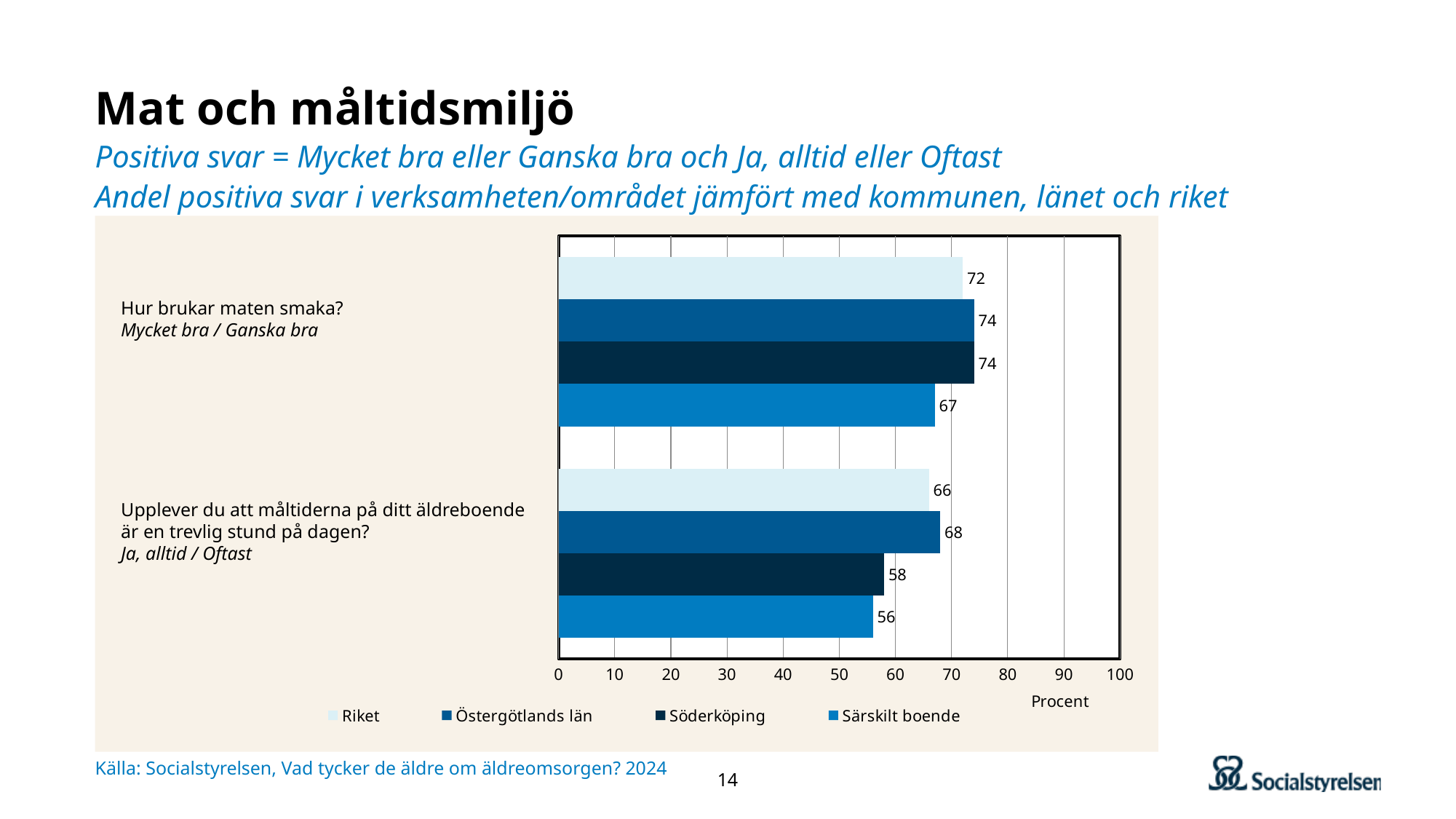
What is the value for Särskilt boende on the question "Hur brukar maten smaka?"? 67 What is the value for Söderköping on the question "Hur brukar maten smaka?"? 74 What unit is shown on the x axis of the chart? Procent Which series has the lowest value on the question "Upplever du att måltiderna på ditt äldreboende är en trevlig stund på dagen?"? Särskilt boende How many series does the legend list? 4 Which series has the highest value on the question "Upplever du att måltiderna på ditt äldreboende är en trevlig stund på dagen?"? Östergötlands län What is the difference between Söderköping and Särskilt boende on the question "Upplever du att måltiderna på ditt äldreboende är en trevlig stund på dagen?"? 2 Which is larger on the question "Upplever du att måltiderna på ditt äldreboende är en trevlig stund på dagen?": Riket or Söderköping? Riket What is the value for Riket on the question "Upplever du att måltiderna på ditt äldreboende är en trevlig stund på dagen?"? 66 What kind of chart is shown on the slide? Bar chart Is the value for Särskilt boende on the question "Upplever du att måltiderna på ditt äldreboende är en trevlig stund på dagen?" greater or less than 60? less What is the difference between Östergötlands län and Särskilt boende on the question "Hur brukar maten smaka?"? 7